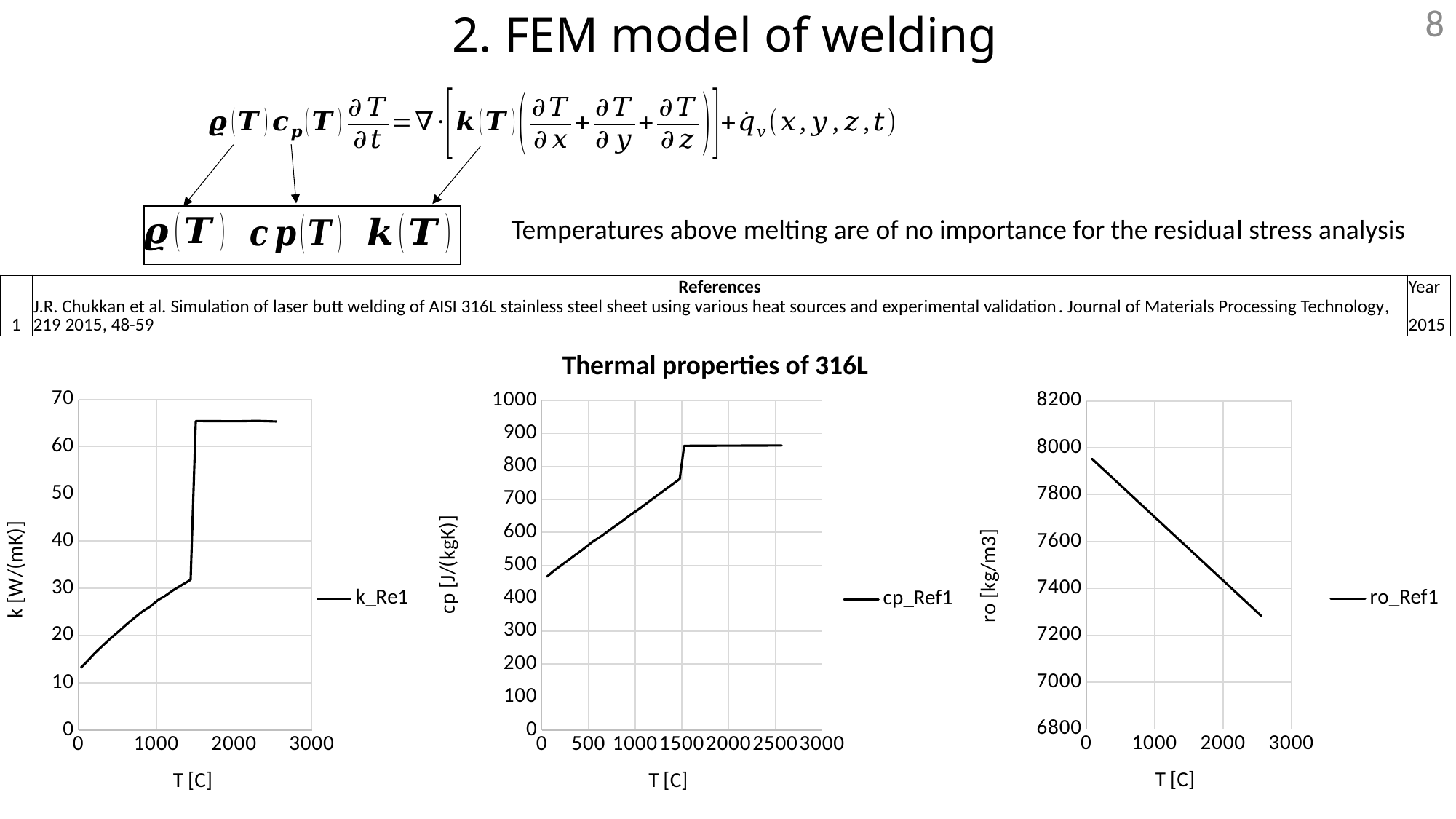
In the middle chart, is the value of cp_Ref1 at T = 2000 greater or less than 800? greater In the middle chart (cp_Ref1), do the values rise or fall as T increases from 0 to 1500? rise In the right chart, is the value of ro_Ref1 at T = 0 greater or less than 8000? less What is the y-axis label of the left chart? k [W/(mK)] What kind of chart is the left chart (k vs T)? line chart How many series does the legend of the middle chart (cp vs T) list? 1 In the right chart, is the value of ro_Ref1 at T = 2500 greater or less than 7400? less What is the name of the series in the legend of the right chart (ro vs T)? ro_Ref1 In the left chart (k_Re1), do the values rise or fall as T increases? rise In the right chart (ro_Ref1), do the values rise or fall as T increases? fall